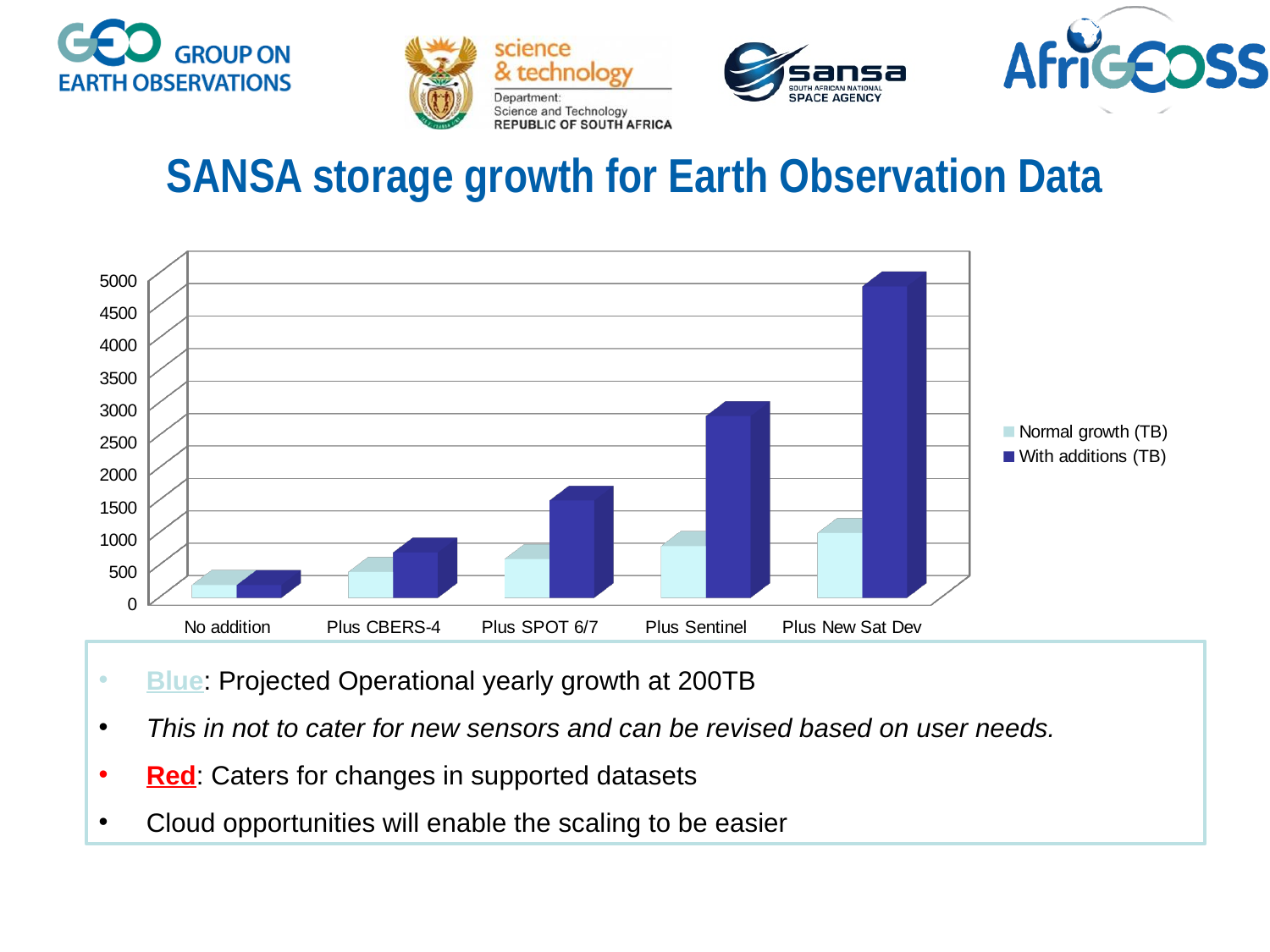
How many series does the legend list? 2 Do the With additions (TB) values rise or fall from No addition to Plus New Sat Dev? rise Is the With additions (TB) value for Plus SPOT 6/7 greater or less than 1000? greater Which category has the lowest value for Normal growth (TB)? No addition What kind of chart is shown on the slide? bar chart What is the title of the chart? SANSA storage growth for Earth Observation Data How many categories are shown on the x axis? 5 Is the With additions (TB) value for Plus Sentinel greater or less than 2500? greater Is the Normal growth (TB) value for Plus New Sat Dev greater or less than 1500? less Which is larger for Plus Sentinel: Normal growth (TB) or With additions (TB)? With additions (TB) Which category has the highest value for With additions (TB)? Plus New Sat Dev